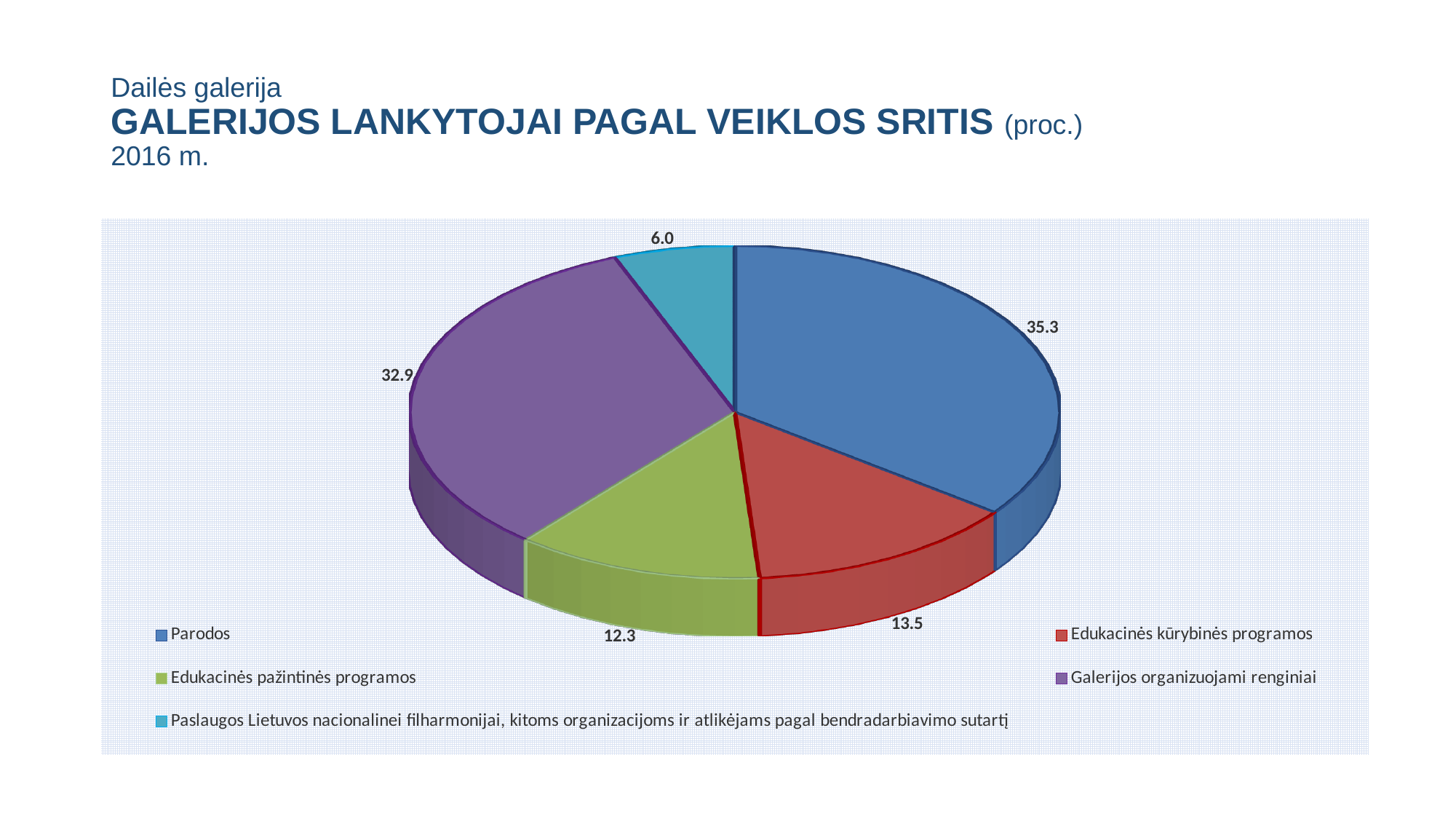
What is the value for Edukacinės kūrybinės programos? 13.5 Which category has the smallest slice of the pie? Paslaugos Lietuvos nacionalinei filharmonijai, kitoms organizacijoms ir atlikėjams pagal bendradarbiavimo sutartį What is the value for Edukacinės pažintinės programos? 12.3 Which is larger, Edukacinės kūrybinės programos or Edukacinės pažintinės programos? Edukacinės kūrybinės programos What is the value for Paslaugos Lietuvos nacionalinei filharmonijai, kitoms organizacijoms ir atlikėjams pagal bendradarbiavimo sutartį? 6.0 What is the value for Galerijos organizuojami renginiai? 32.9 What colour is the slice for Galerijos organizuojami renginiai? purple What kind of chart is shown on the slide? pie chart What is the value for Parodos? 35.3 Which category has the largest slice of the pie? Parodos How many slices does the pie chart have? 5 What is the difference between the values for Parodos and Galerijos organizuojami renginiai? 2.4